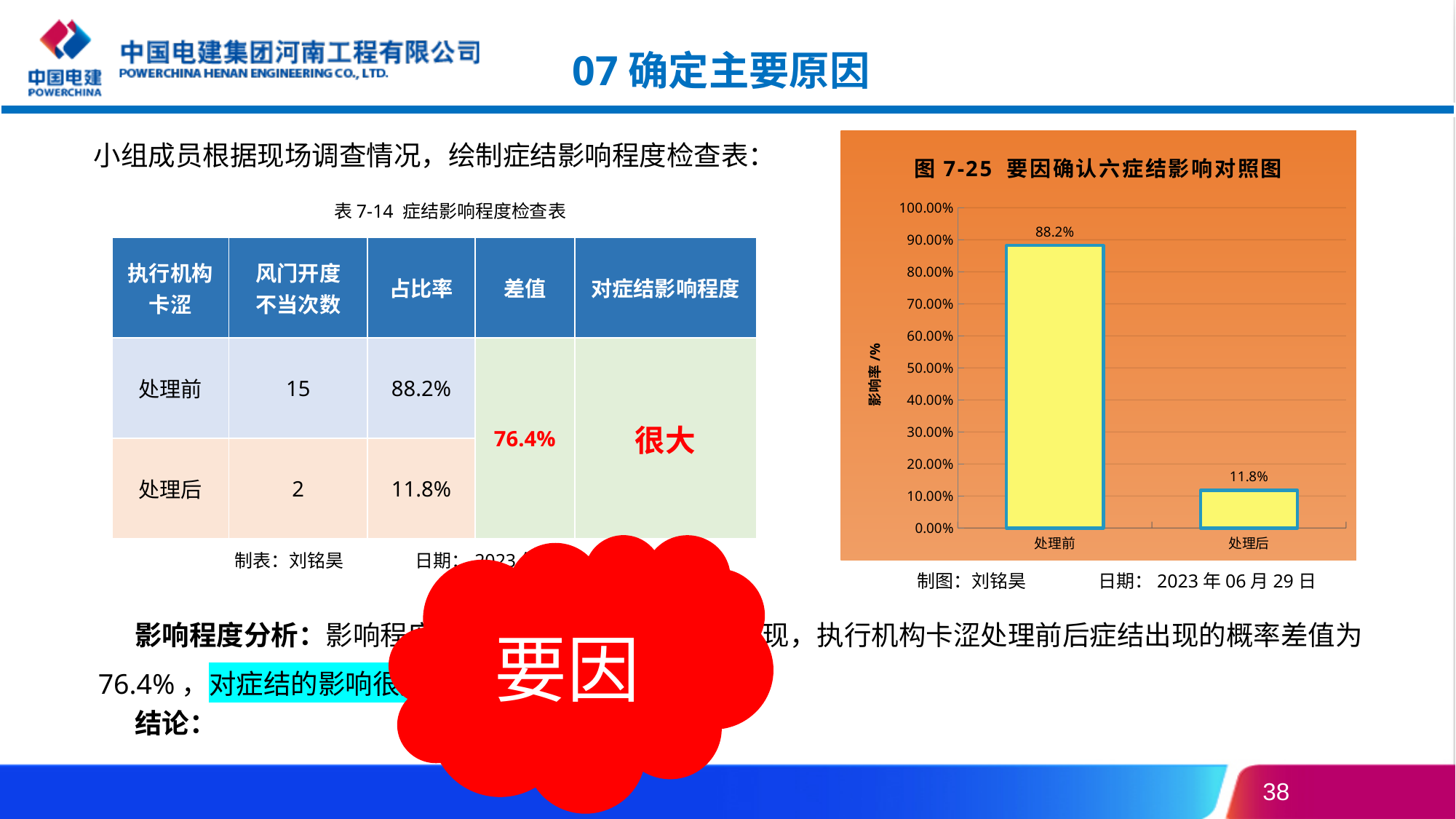
What is the value for 处理前 in the chart? 88.2% Is the value for 处理后 greater or less than 20.00%? less Which category has the lowest value in the chart? 处理后 Is the value for 处理前 greater or less than 80.00%? greater What is the value for 处理后 in the chart? 11.8% How many categories are shown on the x axis of the chart? 2 Do the values rise or fall from 处理前 to 处理后 along the x axis? fall What is the title of the chart? 图 7-25 要因确认六症结影响对照图 What kind of chart is shown on the slide? bar chart Which category has the highest value in the chart? 处理前 Which is larger in the chart, the value for 处理前 or 处理后? 处理前 What is the difference between the values for 处理前 and 处理后 in the chart? 76.4%